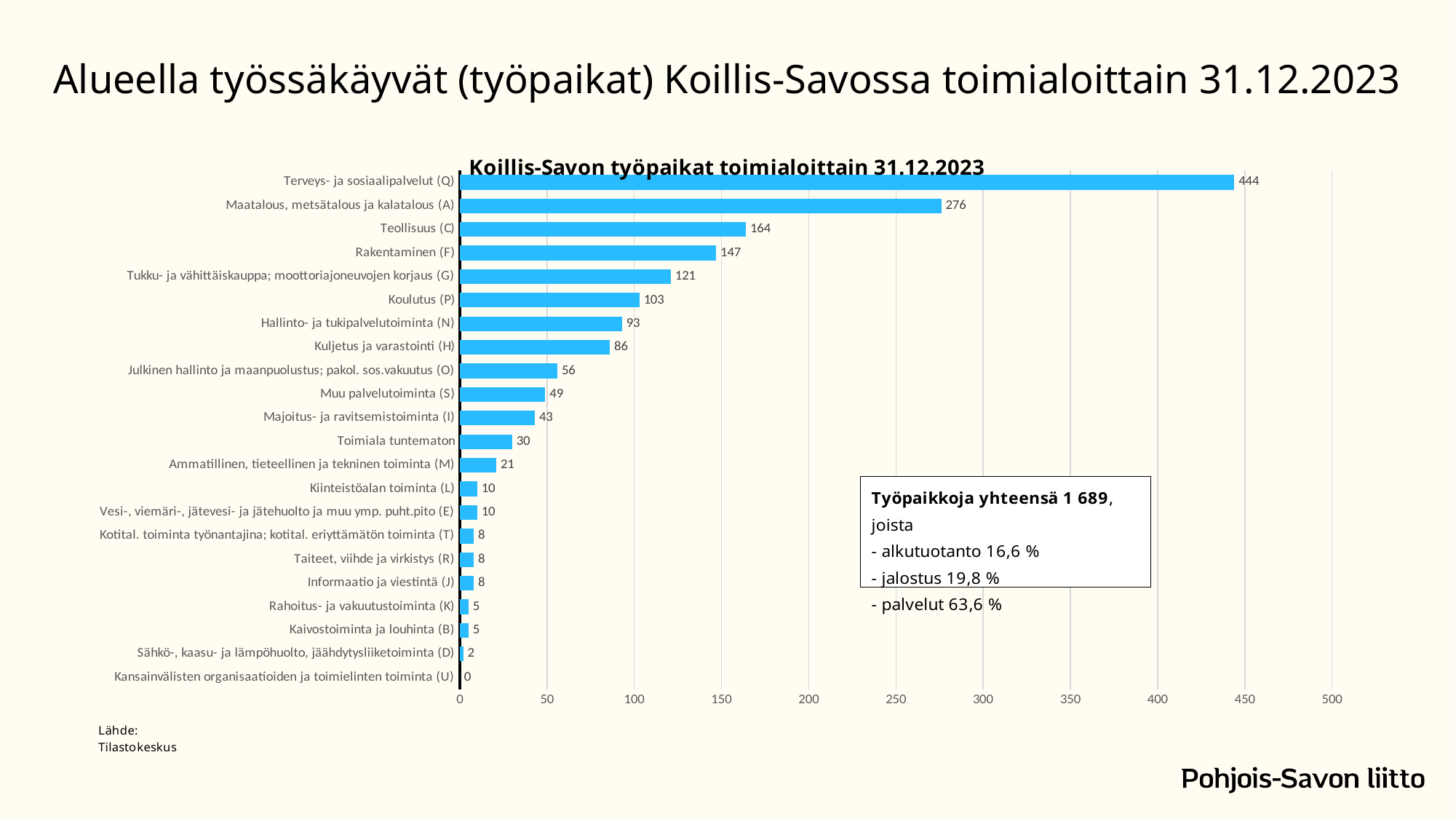
What is the value for Majoitus- ja ravitsemistoiminta (I)? 43 What is the difference between Maatalous, metsätalous ja kalatalous (A) and Teollisuus (C)? 112 What is the value for Terveys- ja sosiaalipalvelut (Q)? 444 Which is larger, Rakentaminen (F) or Tukku- ja vähittäiskauppa; moottoriajoneuvojen korjaus (G)? Rakentaminen (F) Which category has the lowest value? Kansainvälisten organisaatioiden ja toimielinten toiminta (U) How many categories are shown in the chart? 22 What is the title of the chart? Koillis-Savon työpaikat toimialoittain 31.12.2023 What kind of chart is shown on the slide? bar chart Is the value for Kuljetus ja varastointi (H) greater or less than 100? less What is the value for Sähkö-, kaasu- ja lämpöhuolto, jäähdytysliiketoiminta (D)? 2 What is the value for Koulutus (P)? 103 Which category has the highest value? Terveys- ja sosiaalipalvelut (Q)